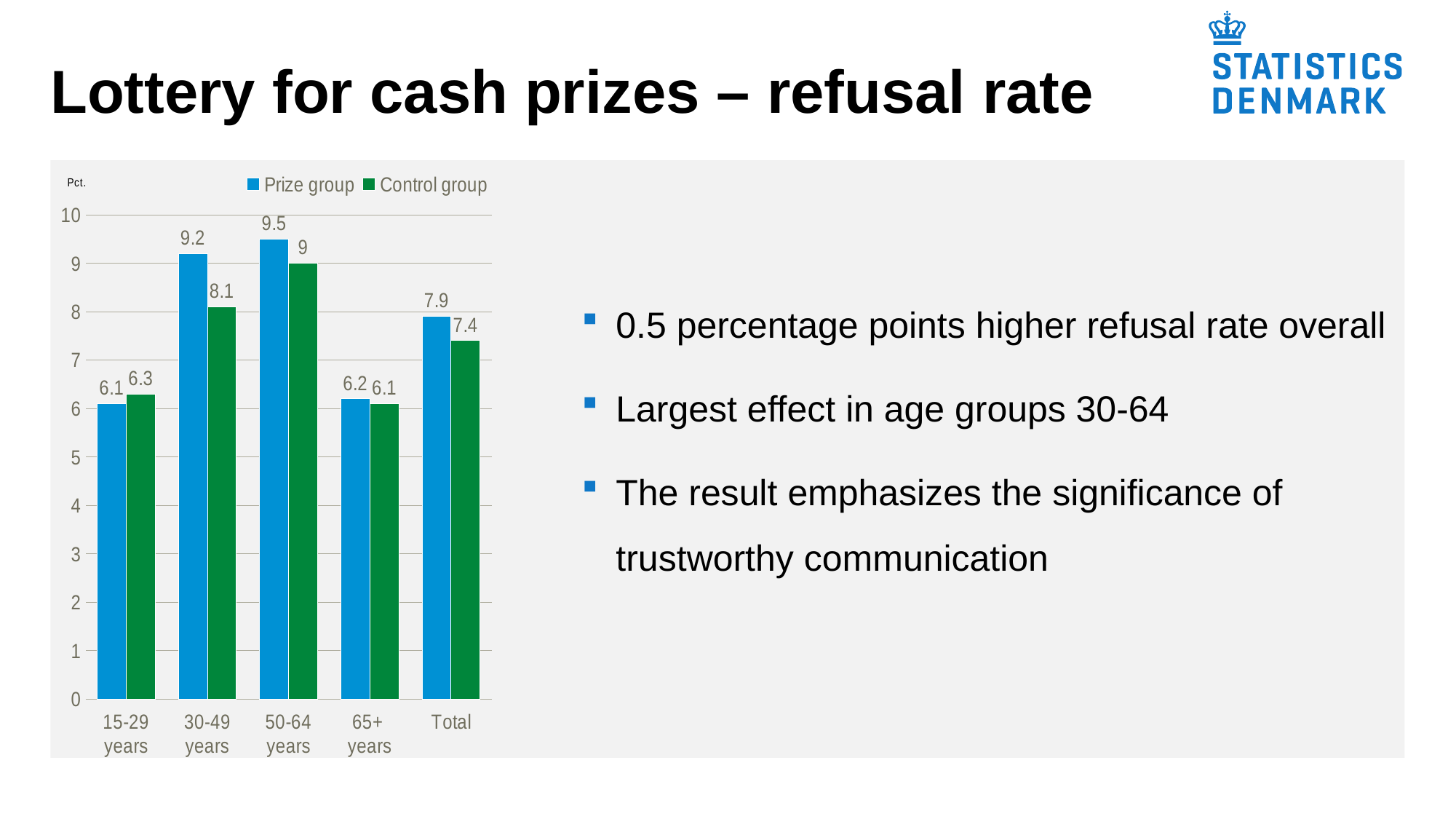
What is the difference between the Prize group and Control group refusal rates for 30-49 years? 1.1 What is the refusal rate for the Prize group in the 30-49 years age group? 9.2 Which age group has the highest Prize group refusal rate? 50-64 years What is the Total refusal rate for the Control group? 7.4 Which age group has the lowest Control group refusal rate? 65+ years How many categories are shown on the x axis? 5 For the 15-29 years age group, which is larger: the Prize group or the Control group refusal rate? Control group Is the Prize group value for 50-64 years greater or less than 9? greater What unit label is shown at the top of the y axis? Pct. How many series does the legend list? 2 What kind of chart is shown on the slide? Bar chart What is the refusal rate for the Control group in the 50-64 years age group? 9